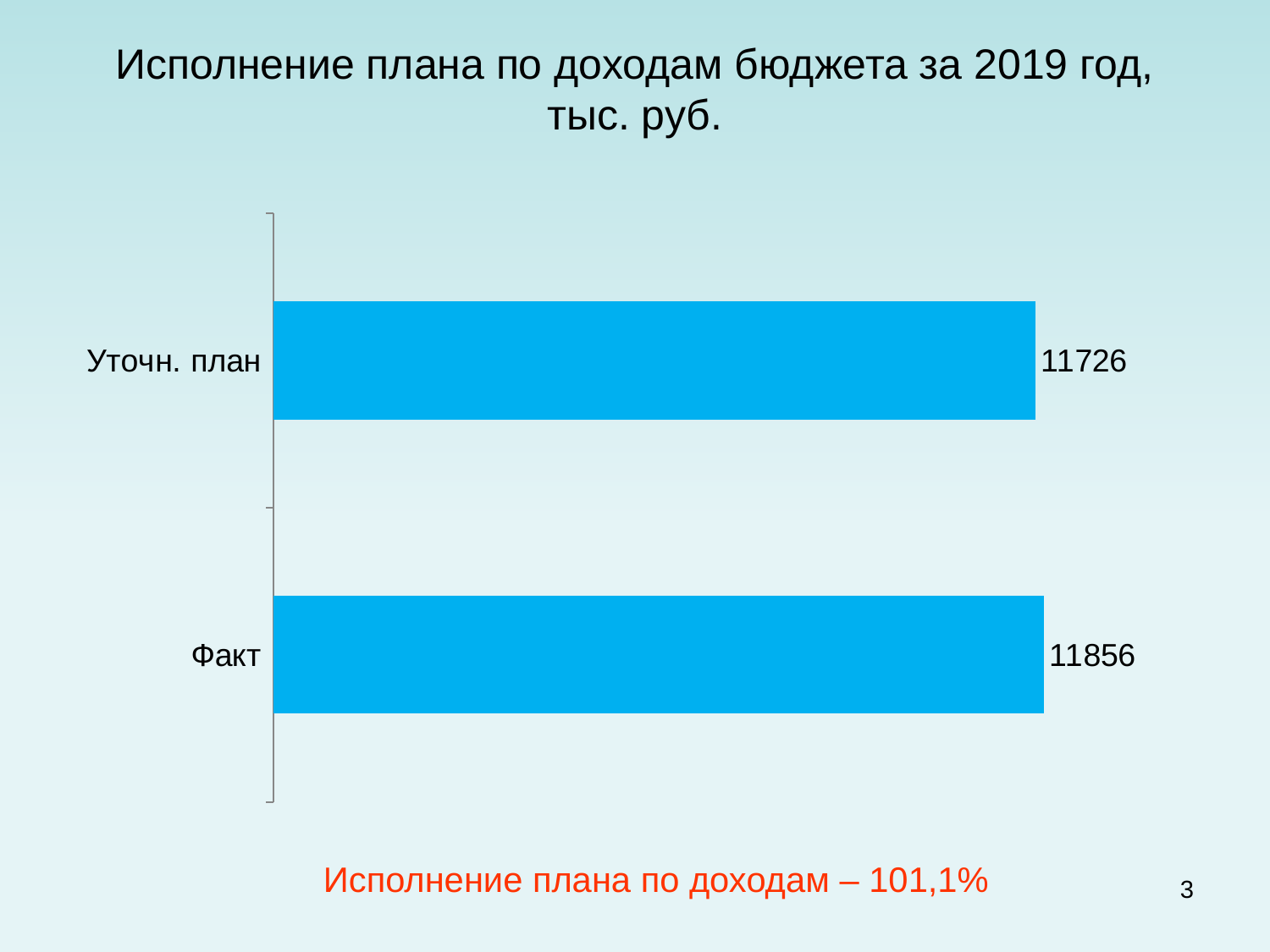
What is the value for Уточн. план? 11726 How many categories are shown in the chart? 2 What is the title of the chart? Исполнение плана по доходам бюджета за 2019 год, тыс. руб. What kind of chart is shown on the slide? bar chart Which is larger, the value for Факт or the value for Уточн. план? Факт What is the difference between the values for Факт and Уточн. план? 130 What is the value for Факт? 11856 Which category has the lowest value? Уточн. план What percentage of plan execution for revenues is stated below the chart? 101,1% Which category has the highest value? Факт